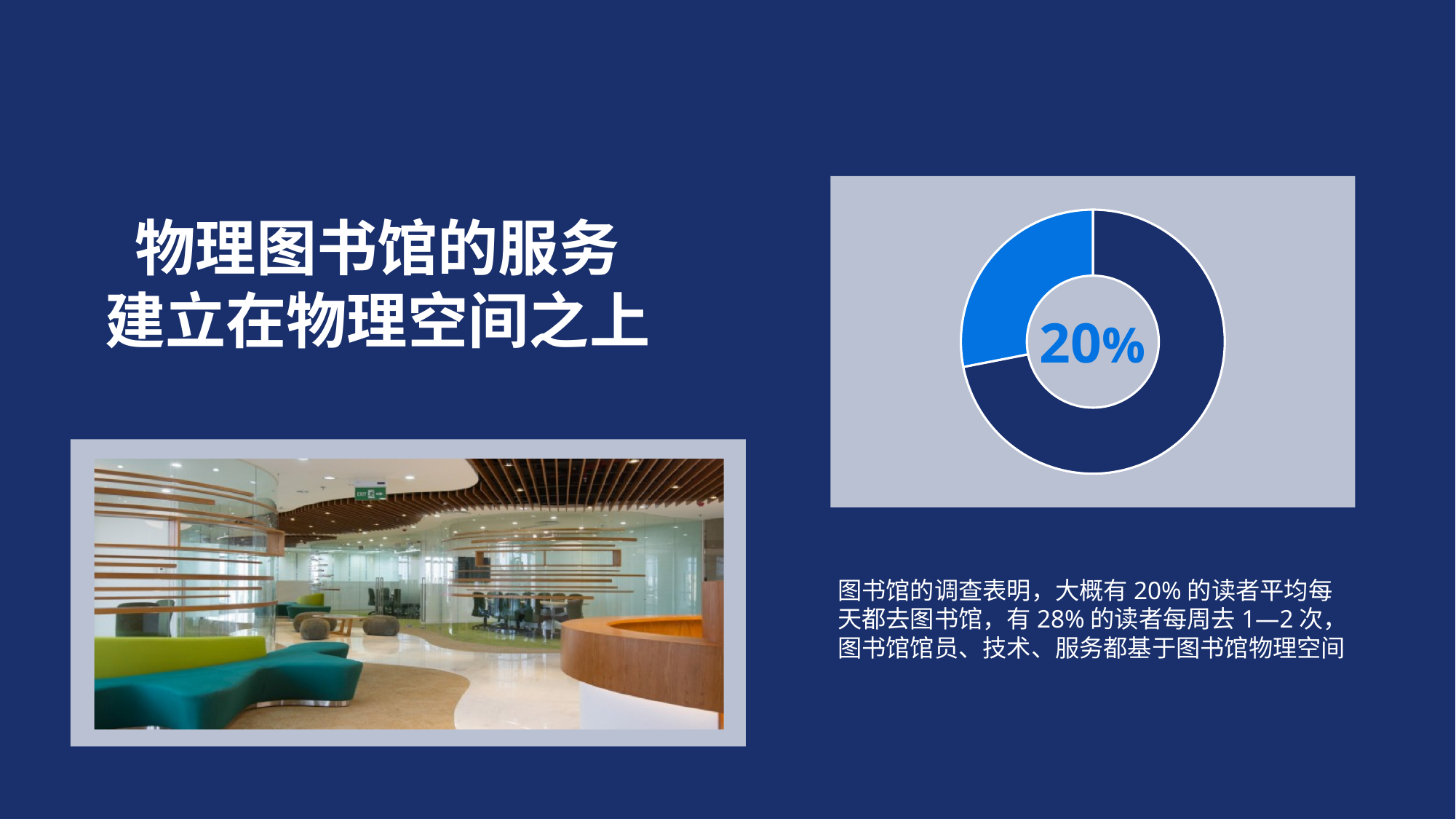
What colour is the smaller, highlighted slice of the doughnut chart? Light blue What percentage value is printed in the centre of the doughnut chart? 20% Does the doughnut chart have a legend? No What kind of chart is shown on the right side of the slide? Doughnut chart How many slices does the doughnut chart have? 2 Which slice of the doughnut chart is larger, the dark blue one or the light blue one? The dark blue one